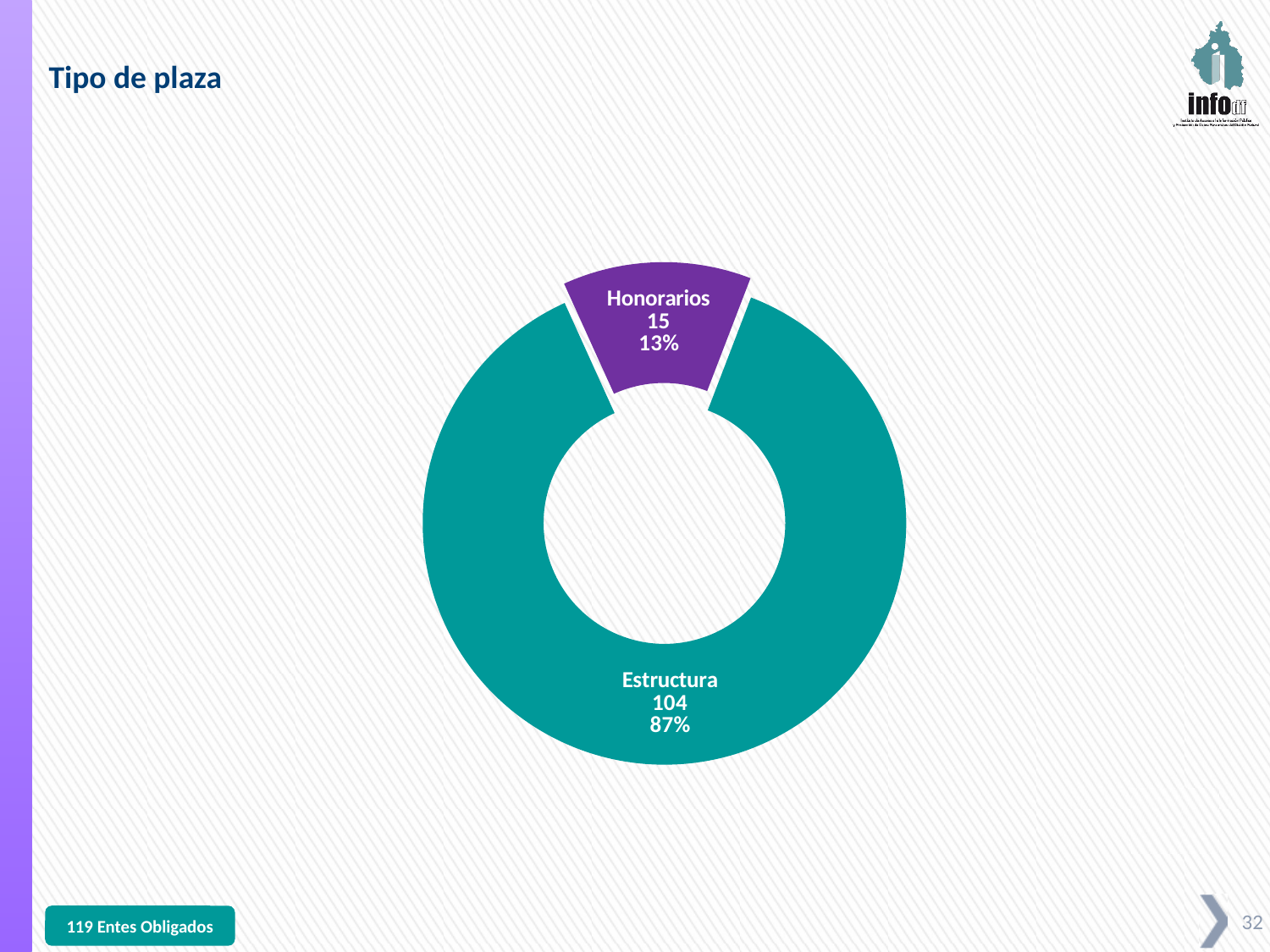
What percentage share does Honorarios have? 13% What is the total of the two values shown in the chart? 119 What is the title of the slide containing the chart? Tipo de plaza What is the difference between the values for Estructura and Honorarios? 89 What percentage share does Estructura have? 87% Which category has the lowest value? Honorarios Which is larger, Estructura or Honorarios? Estructura Which category has the highest value? Estructura How many categories does the chart show? 2 What kind of chart is shown on the slide? Doughnut chart What is the value for Estructura? 104 What is the value for Honorarios? 15